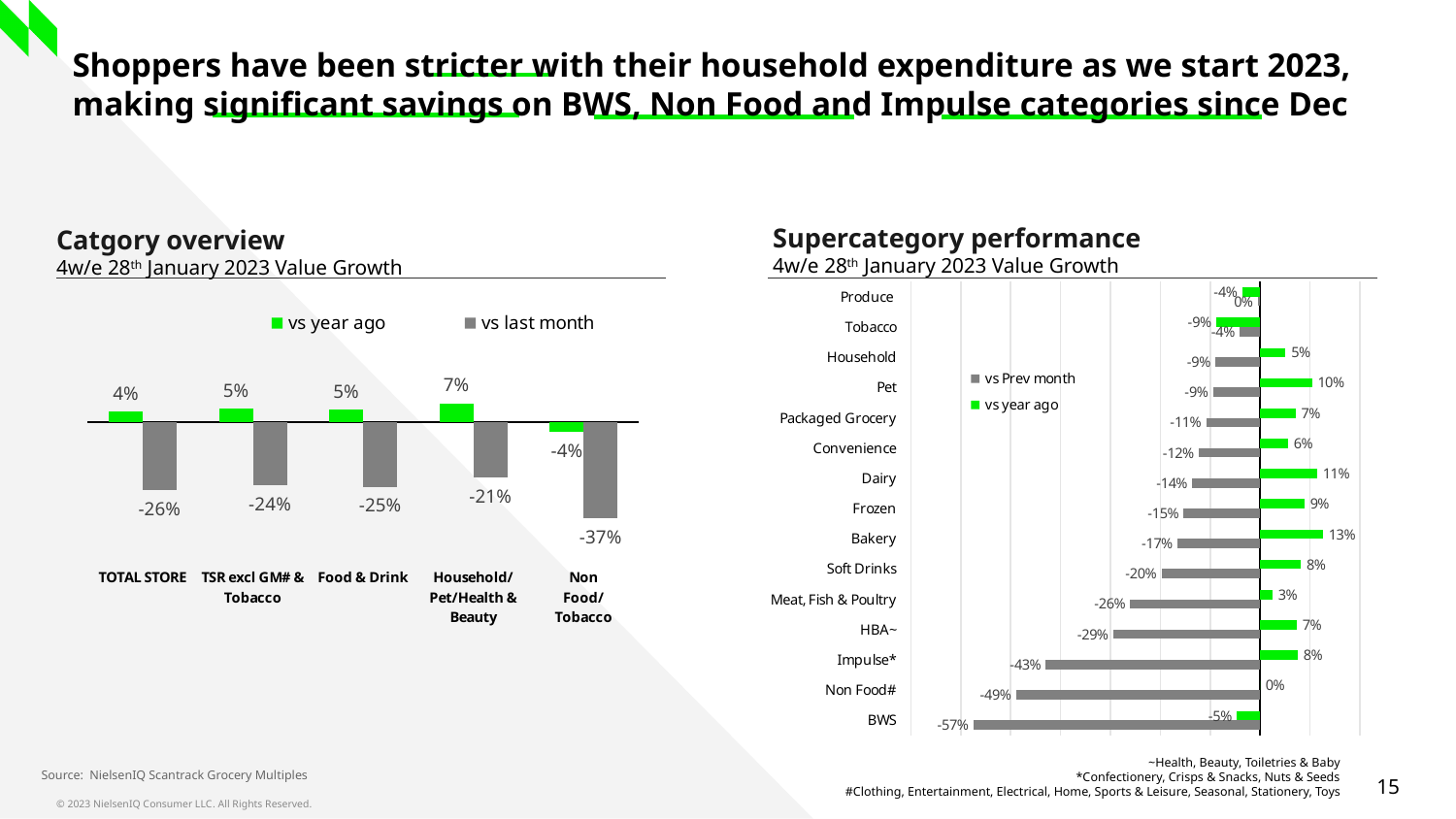
In the Catgory overview chart, how many series does the legend list? 2 In the Supercategory performance chart, how many supercategories are listed? 15 In the Catgory overview chart, what is the 'vs last month' value for TOTAL STORE? -26% In the Catgory overview chart, how many categories are shown on the x axis? 5 In the Supercategory performance chart, what is the 'vs Prev month' value for BWS? -57% In the Supercategory performance chart, which is larger, the 'vs Prev month' value for Impulse* or for Non Food#? Impulse* In the Supercategory performance chart, which supercategory has the highest 'vs year ago' value? Bakery In the Catgory overview chart, what is the difference between the 'vs year ago' and 'vs last month' values for Food & Drink? 30 percentage points What type of chart is the Supercategory performance chart? Bar chart In the Supercategory performance chart, what is the 'vs year ago' value for Bakery? 13% In the Catgory overview chart, which category has the lowest 'vs last month' value? Non Food/Tobacco In the Catgory overview chart, what is the 'vs year ago' value for Household/Pet/Health & Beauty? 7%